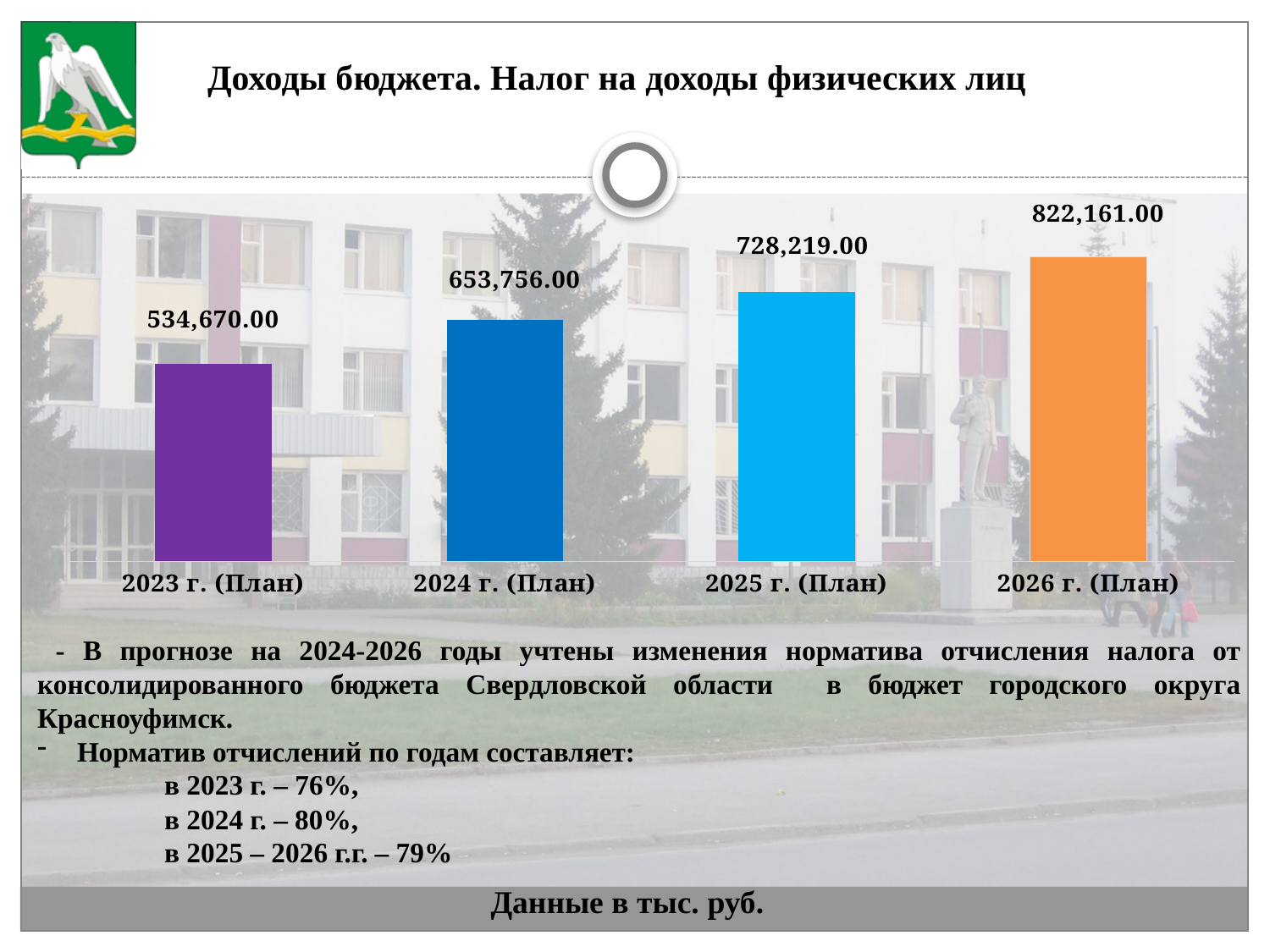
Which category has the highest value? 2026 г. (План) Which category has the lowest value? 2023 г. (План) Which is larger, the value for 2024 г. (План) or the value for 2025 г. (План)? 2025 г. (План) What is the title of the slide containing the chart? Доходы бюджета. Налог на доходы физических лиц What kind of chart is shown on the slide? Bar chart What is the difference between the values for 2026 г. (План) and 2025 г. (План)? 93,942.00 What is the value for 2025 г. (План)? 728,219.00 Do the values rise or fall from 2023 г. (План) to 2026 г. (План)? Rise What is the value for 2026 г. (План)? 822,161.00 How many categories are shown in the chart? 4 What is the value for 2023 г. (План)? 534,670.00 What is the difference between the values for 2024 г. (План) and 2023 г. (План)? 119,086.00